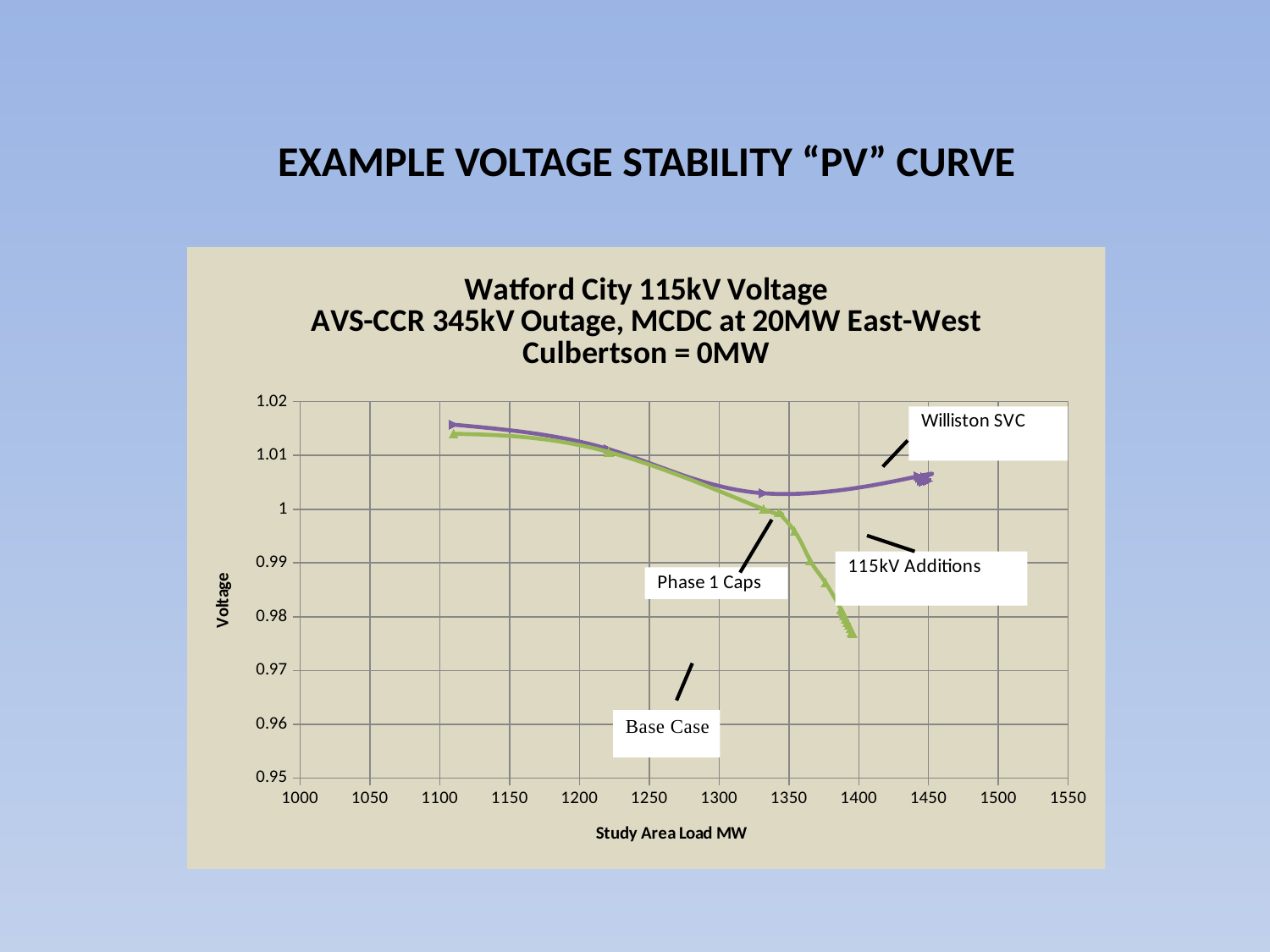
At a load of 1350 MW, which line has the higher voltage, the purple line or the green line? purple line Is the value of the green line at a load of 1100 MW greater or less than 1.01? greater What kind of chart is shown on the slide? line chart How many lines are plotted on the chart? 2 Is the value of the green line at a load of 1400 MW greater or less than 0.98? less Is the value of the purple line at a load of 1100 MW greater or less than 1.01? greater What is the title of the chart? Watford City 115kV Voltage AVS-CCR 345kV Outage, MCDC at 20MW East-West Culbertson = 0MW What is the label of the x axis? Study Area Load MW What is the highest value shown on the Voltage axis? 1.02 Does the green line rise or fall as the study area load increases? fall